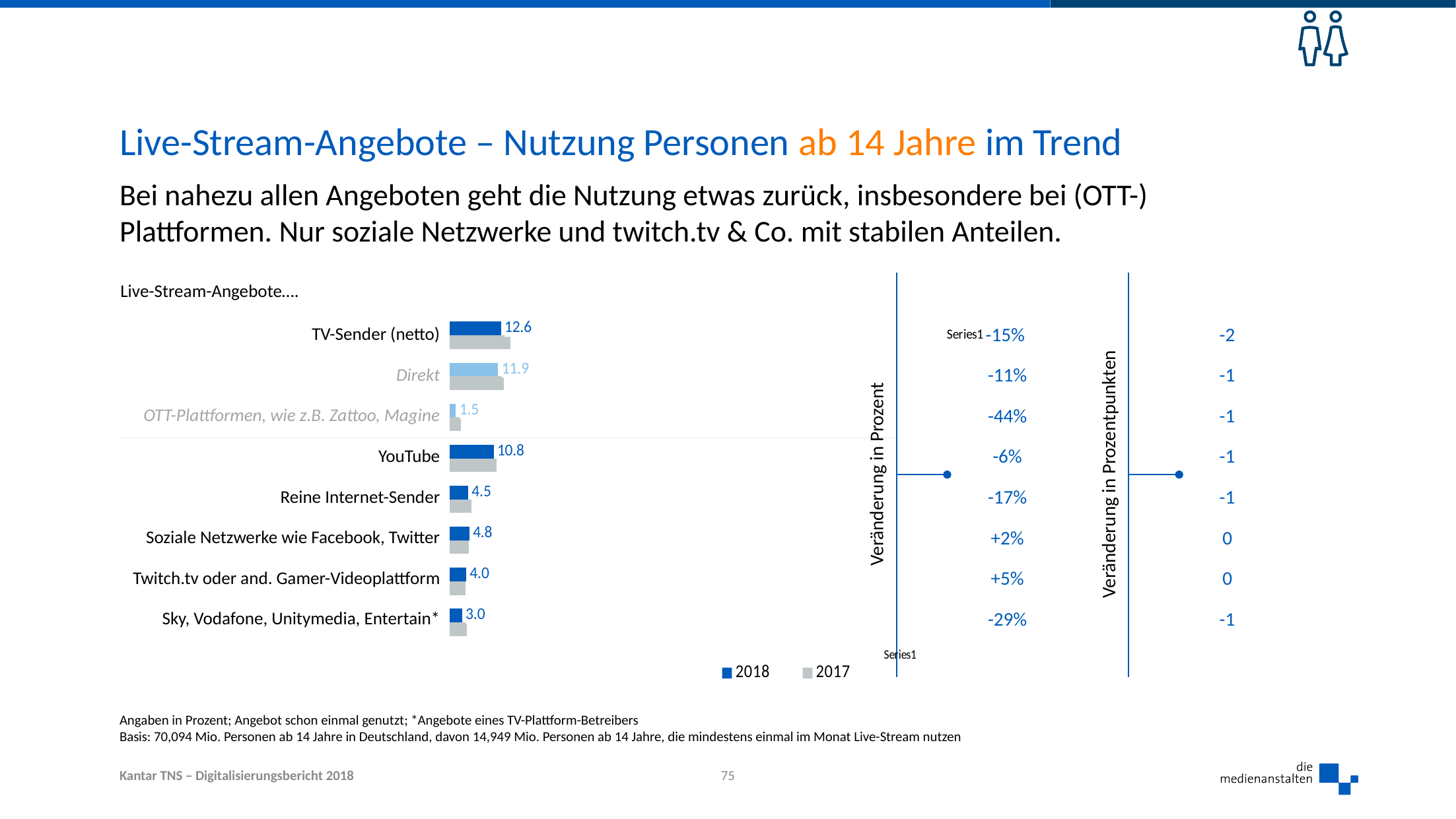
How many series does the legend list? 2 How many categories are shown in the bar chart? 8 What is the 2018 value for TV-Sender (netto)? 12.6 What is the 2018 value for YouTube? 10.8 Which category has the lowest 2018 value? OTT-Plattformen, wie z.B. Zattoo, Magine What is the difference between the 2018 values for TV-Sender (netto) and YouTube? 1.8 What is the difference between the 2018 values for Direkt and OTT-Plattformen, wie z.B. Zattoo, Magine? 10.4 Which has the larger 2018 value, Soziale Netzwerke wie Facebook, Twitter or Reine Internet-Sender? Soziale Netzwerke wie Facebook, Twitter What kind of chart is used to show the Live-Stream-Angebote values? Bar chart Which category has the highest 2018 value? TV-Sender (netto) What is the 2018 value for Sky, Vodafone, Unitymedia, Entertain*? 3.0 What is the 2018 value for Twitch.tv oder and. Gamer-Videoplattform? 4.0